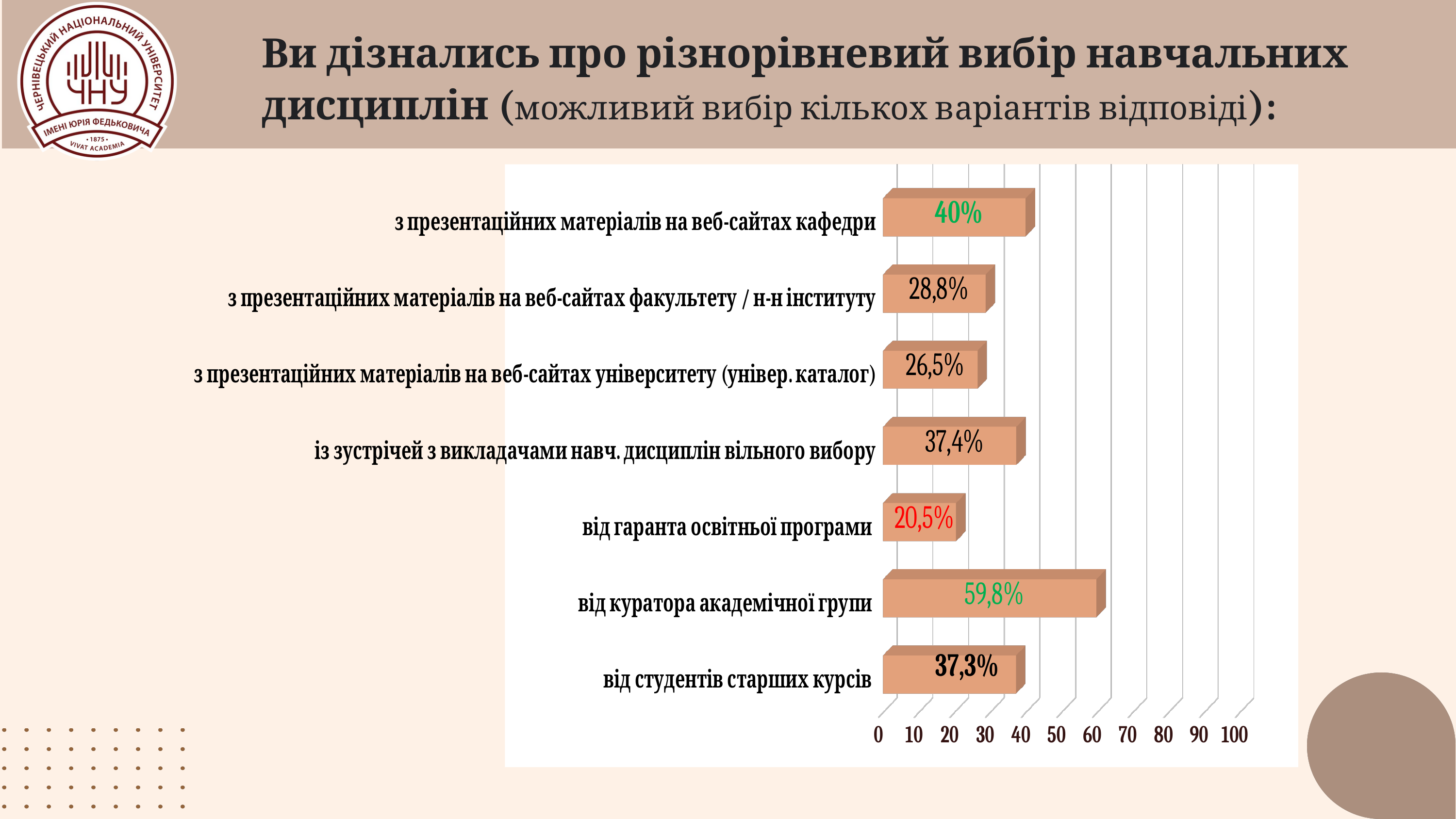
What is the difference between the values for «від куратора академічної групи» and «від гаранта освітньої програми»? 39,3 percentage points In what colour is the data label for «від гаранта освітньої програми» printed? Red Which is larger: the value for «з презентаційних матеріалів на веб-сайтах кафедри» or for «з презентаційних матеріалів на веб-сайтах факультету / н-н інституту»? з презентаційних матеріалів на веб-сайтах кафедри How many categories are shown in the chart? 7 Which category has the highest value? від куратора академічної групи What kind of chart is shown on the slide? Bar chart What is the value for «з презентаційних матеріалів на веб-сайтах університету (універ. каталог)»? 26,5% What is the value for «від куратора академічної групи»? 59,8% What is the value for «з презентаційних матеріалів на веб-сайтах кафедри»? 40% Which category has the lowest value? від гаранта освітньої програми What is the value for «від гаранта освітньої програми»? 20,5% What is the value for «із зустрічей з викладачами навч. дисциплін вільного виборy»? 37,4%